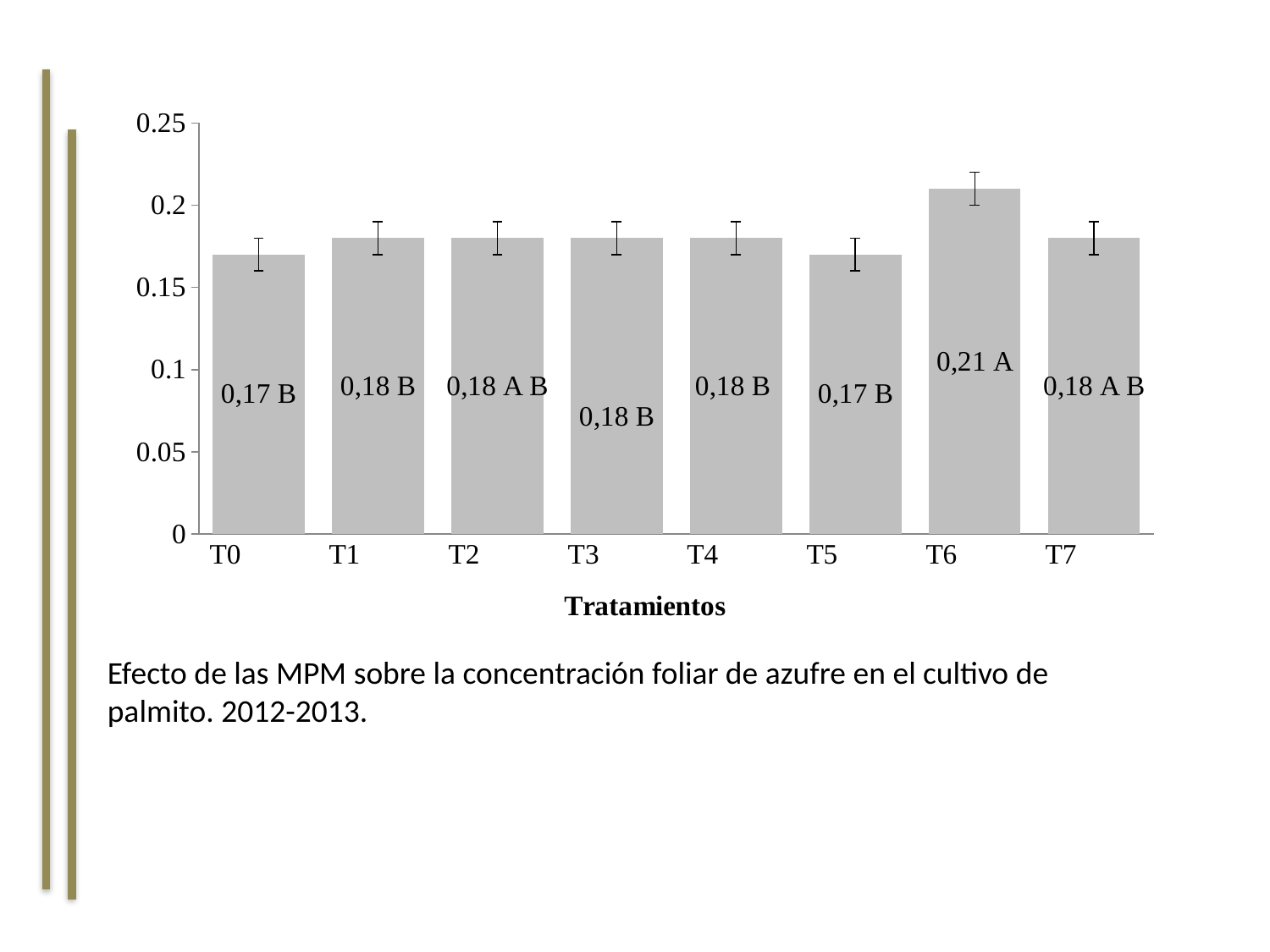
What is the title of the x axis? Tratamientos Which is larger, the value for T6 or the value for T5? T6 Is the value for T5 greater or less than 0.2? less How many treatments are shown on the x axis? 8 Is the value for T6 greater or less than 0.2? greater What is the value for T6? 0,21 What is the difference between the values for T6 and T0? 0,04 What is the value for T0? 0,17 What kind of chart is this? bar chart Which treatment has the highest value? T6 What is the value for T3? 0,18 What is the difference between the values for T6 and T1? 0,03